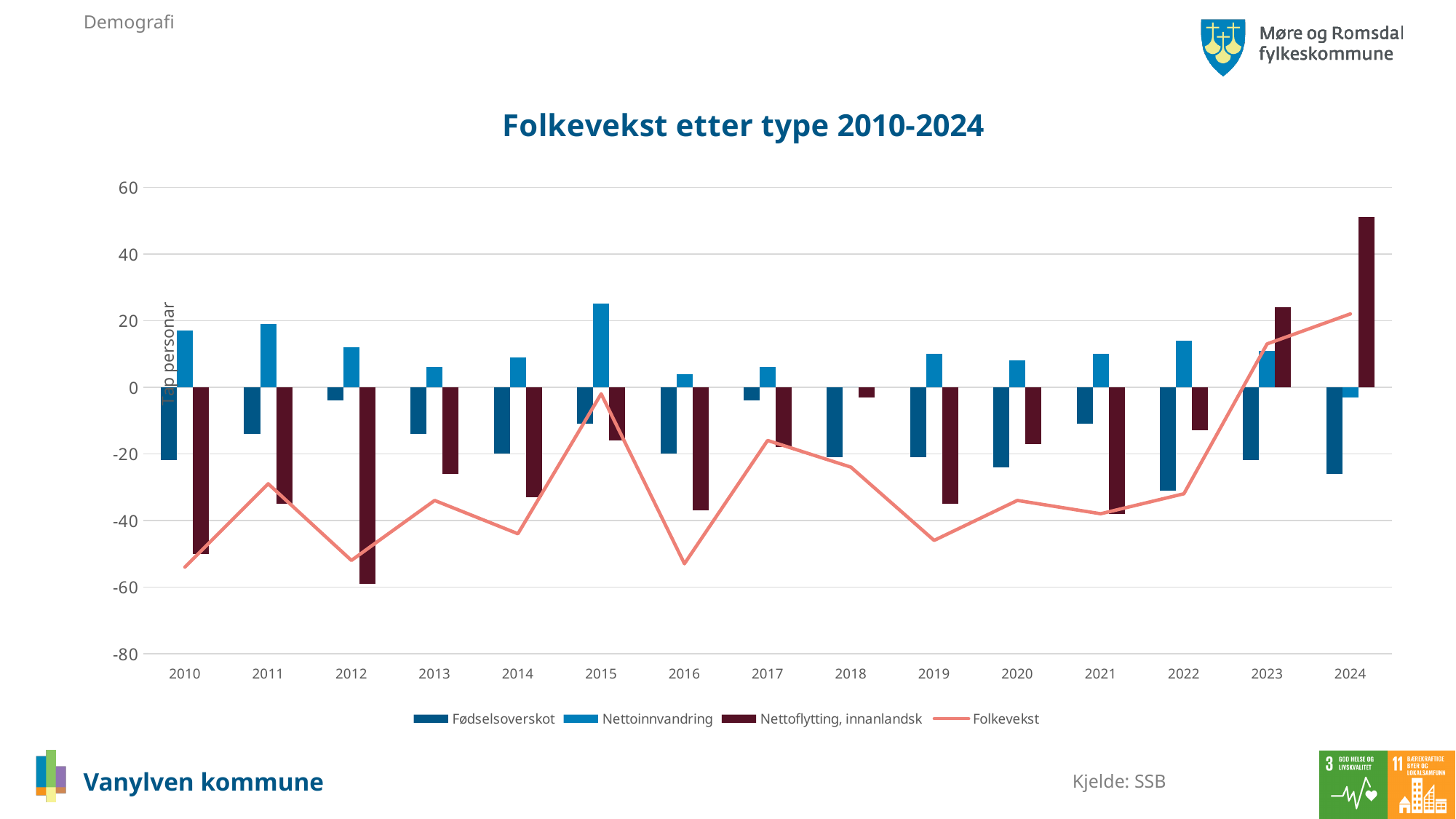
Is the Folkevekst value in 2016 greater or less than -40? less Does the Folkevekst line rise or fall from 2021 to 2024? rise Is the value for Nettoflytting, innanlandsk in 2012 greater or less than -40? less In which year is Nettoflytting, innanlandsk lowest? 2012 How many series does the legend list? 4 Which year has the larger Nettoinnvandring value, 2010 or 2013? 2010 In which year is Nettoflytting, innanlandsk highest? 2024 How many years are shown on the x axis? 15 Is the value for Nettoflytting, innanlandsk in 2024 greater or less than 40? greater In which year is Nettoinnvandring highest? 2015 What kind of chart is shown on the slide? bar chart with a line What is the title of the chart? Folkevekst etter type 2010-2024